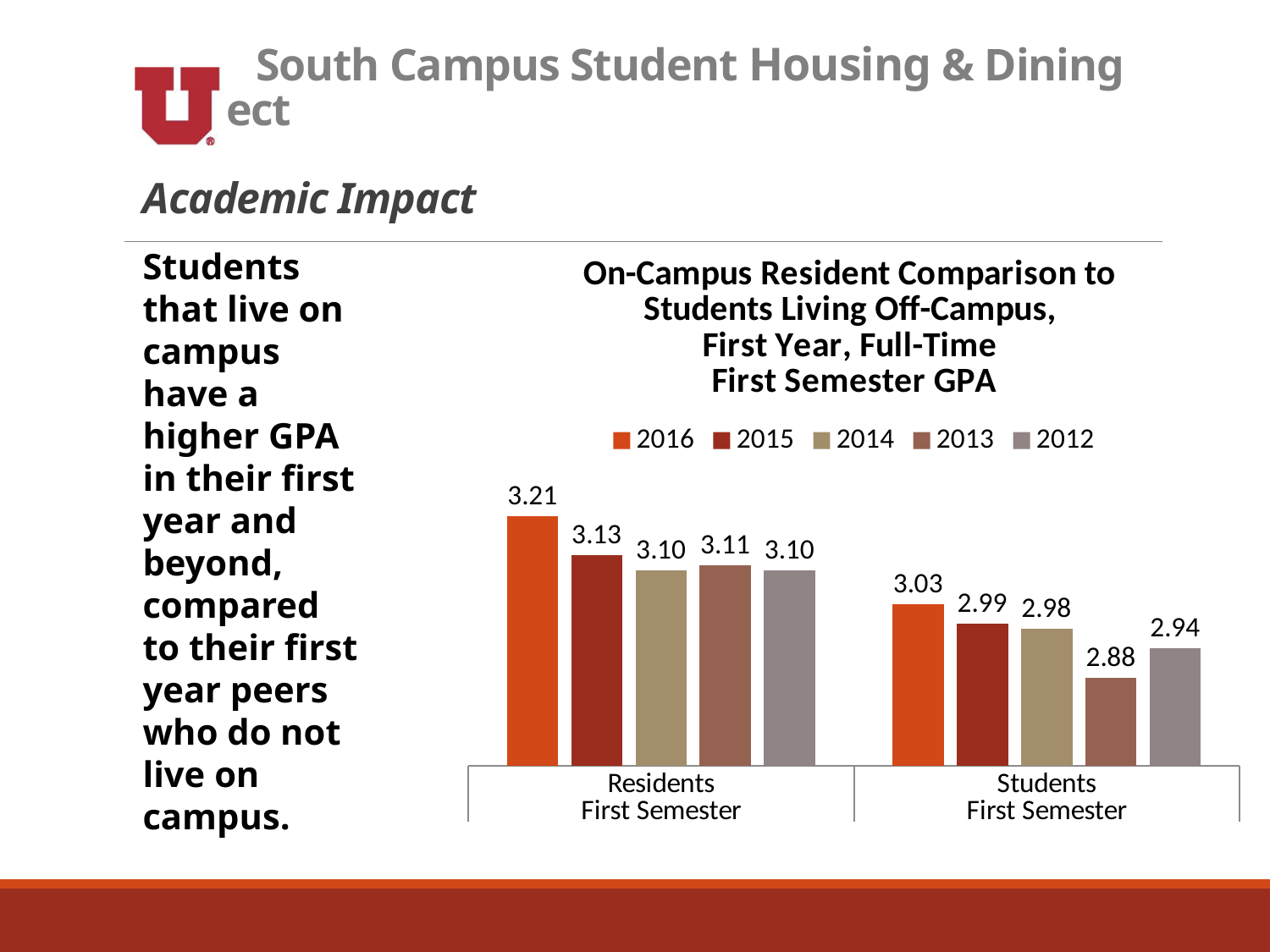
Which year has the highest value for Students First Semester? 2016 How many categories are shown on the x axis? 2 What is the 2016 value for Residents First Semester? 3.21 Which year has the highest value for Residents First Semester? 2016 Which year has the lowest value for Students First Semester? 2013 How many series does the legend list? 5 What is the 2014 value for Residents First Semester? 3.10 Which is larger: the 2015 value for Residents First Semester or the 2015 value for Students First Semester? Residents First Semester What is the 2012 value for Students First Semester? 2.94 What is the difference between the 2016 values for Residents First Semester and Students First Semester? 0.18 What kind of chart is shown on the slide? Bar chart What is the 2013 value for Students First Semester? 2.88